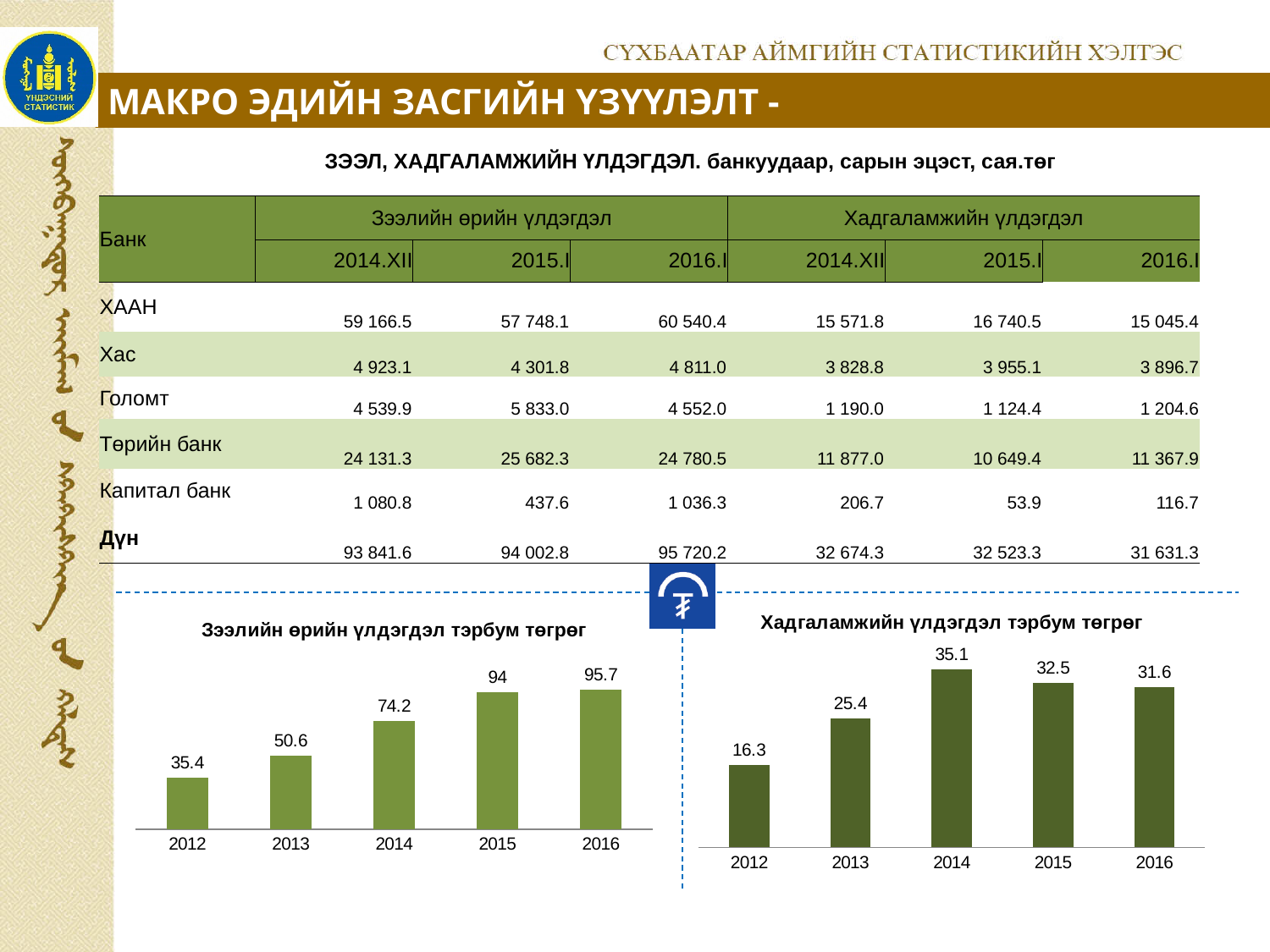
What type of chart is the right chart (Хадгаламжийн үлдэгдэл тэрбум төгрөг)? bar chart In the right chart (Хадгаламжийн үлдэгдэл тэрбум төгрөг), which is larger, the value for 2015 or the value for 2013? 2015 In the left chart (Зээлийн өрийн үлдэгдэл тэрбум төгрөг), how many years are shown? 5 In the right chart (Хадгаламжийн үлдэгдэл тэрбум төгрөг), which year has the lowest value? 2012 In the left chart (Зээлийн өрийн үлдэгдэл тэрбум төгрөг), what is the value for 2014? 74.2 In the left chart (Зээлийн өрийн үлдэгдэл тэрбум төгрөг), what is the difference between the 2015 and 2013 values? 43.4 In the left chart (Зээлийн өрийн үлдэгдэл тэрбум төгрөг), what is the value for 2012? 35.4 In the right chart (Хадгаламжийн үлдэгдэл тэрбум төгрөг), which year has the highest value? 2014 In the left chart (Зээлийн өрийн үлдэгдэл тэрбум төгрөг), do the values rise or fall from 2012 to 2016? rise In the left chart (Зээлийн өрийн үлдэгдэл тэрбум төгрөг), which year has the highest value? 2016 In the right chart (Хадгаламжийн үлдэгдэл тэрбум төгрөг), what is the value for 2013? 25.4 In the right chart (Хадгаламжийн үлдэгдэл тэрбум төгрөг), what is the difference between the 2014 and 2016 values? 3.5